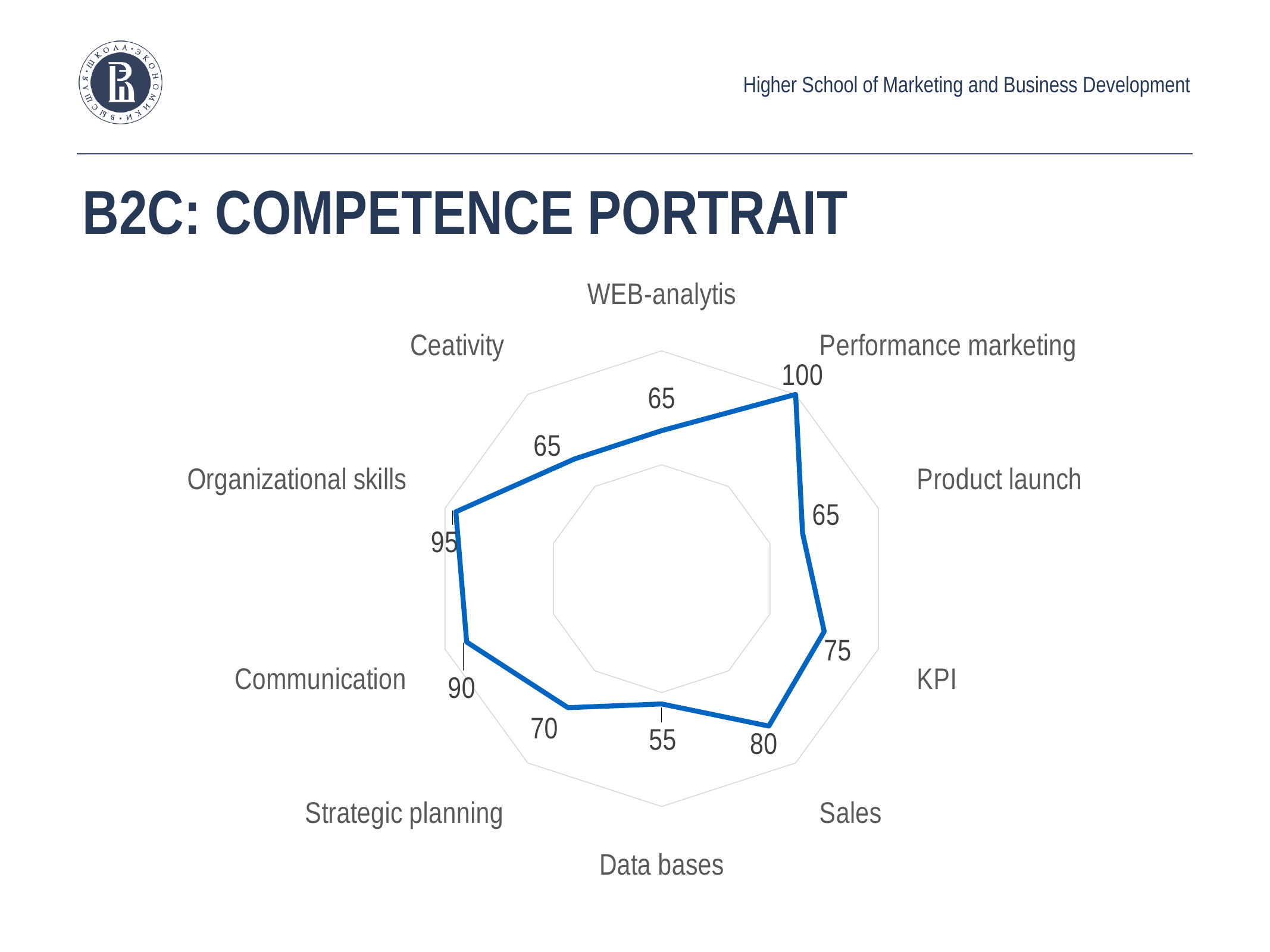
Which category has the lowest value? Data bases What is the value for Communication? 90 What kind of chart is shown on the slide? Radar chart What is the value for KPI? 75 Which is larger, the value for Sales or the value for KPI? Sales Which category has the highest value? Performance marketing What is the value for Data bases? 55 How many categories are plotted on the chart? 10 What is the difference between the values for Organizational skills and Strategic planning? 25 What is the value for Performance marketing? 100 What is the difference between the values for Performance marketing and Data bases? 45 What is the value for Organizational skills? 95